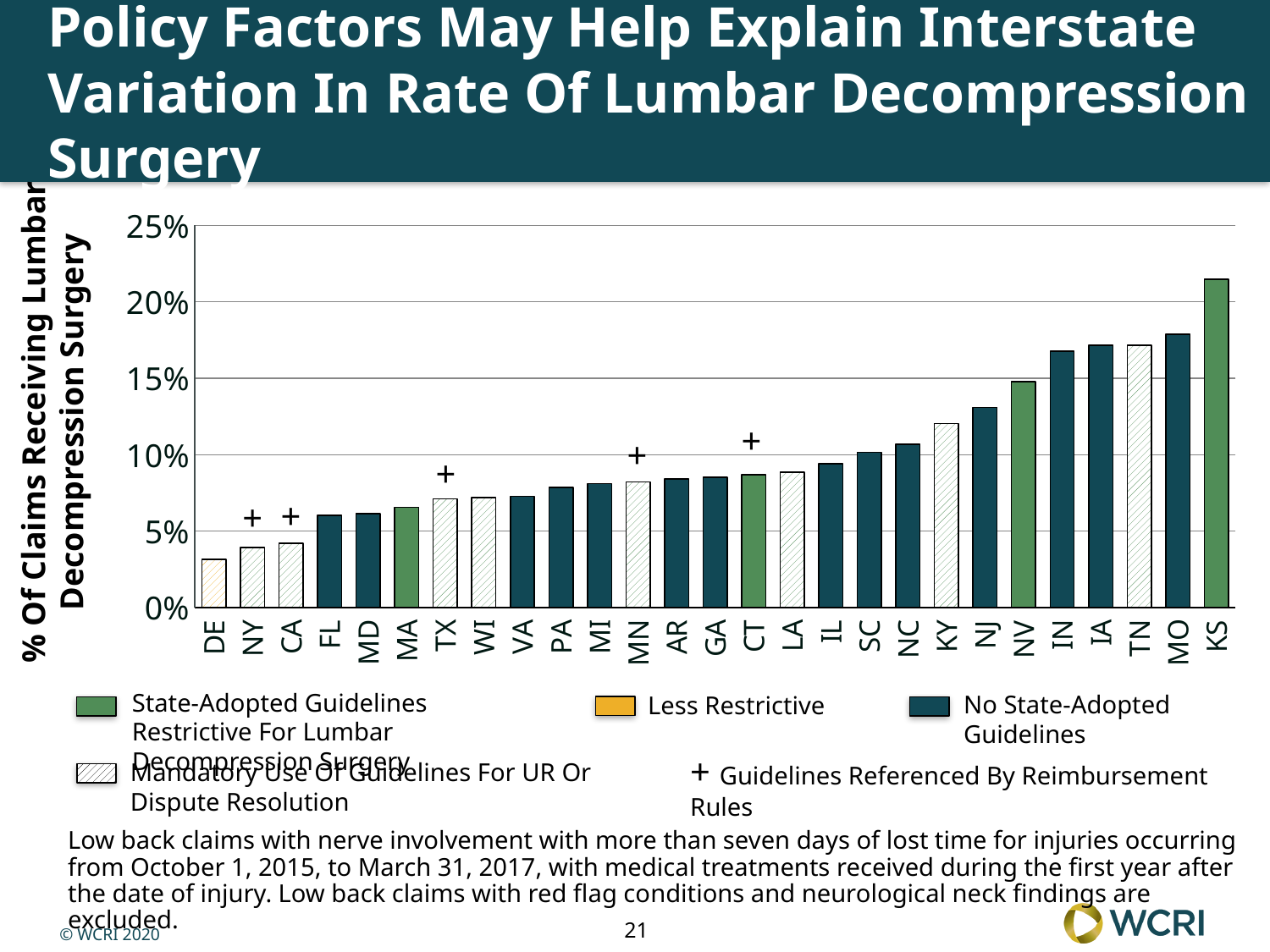
Is the value for IN greater or less than 15%? greater Is the value for DE greater or less than 5%? less Is the value for LA greater or less than 10%? less What kind of chart is shown on the slide? Bar chart Which state has the lowest percentage of claims receiving lumbar decompression surgery? DE Which state has a higher value, KS or MO? KS Which state has the highest percentage of claims receiving lumbar decompression surgery? KS How many states are shown on the x axis of the chart? 27 Which state has a higher value, IN or NV? IN Do the values generally rise or fall moving from left to right along the x axis? Rise